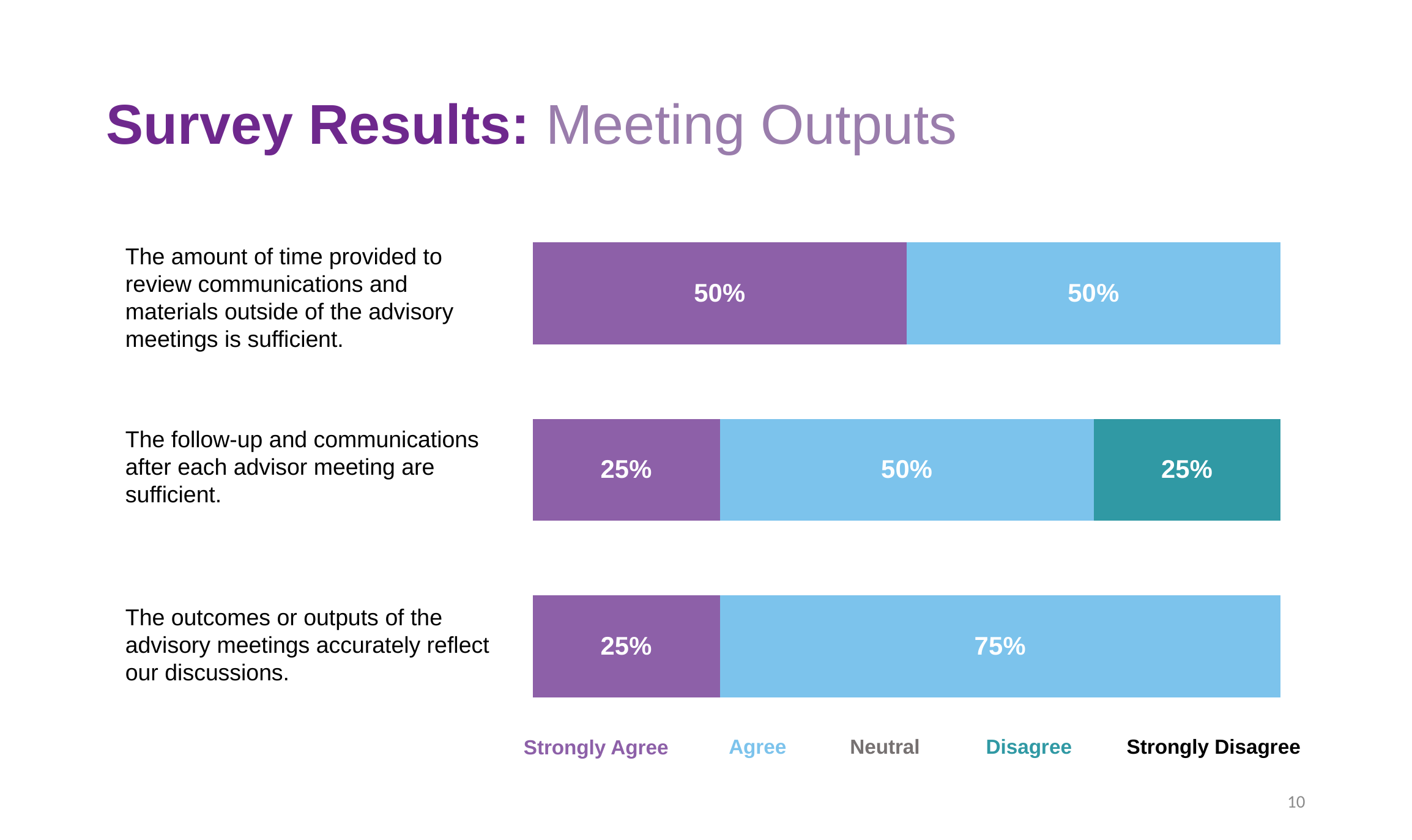
Which statement is the only one with any 'Disagree' responses? The follow-up and communications after each advisor meeting are sufficient. What percentage of respondents strongly agree that the amount of time provided to review communications and materials outside of the advisory meetings is sufficient? 50% What kind of chart is shown on the slide? Stacked bar chart Which statement has the highest share of 'Agree' responses? The outcomes or outputs of the advisory meetings accurately reflect our discussions. What percentage of respondents disagree that the follow-up and communications after each advisor meeting are sufficient? 25% What percentage of respondents strongly agree that the outcomes or outputs of the advisory meetings accurately reflect their discussions? 25% What percentage of respondents agree that the outcomes or outputs of the advisory meetings accurately reflect their discussions? 75% What percentage of respondents agree that the follow-up and communications after each advisor meeting are sufficient? 50% How many response categories does the legend list? 5 How many statements (bars) are shown on the slide? 3 For the statement about outcomes or outputs accurately reflecting discussions, what is the difference between the 'Agree' and 'Strongly Agree' percentages? 50% Which legend entry is shown in purple? Strongly Agree